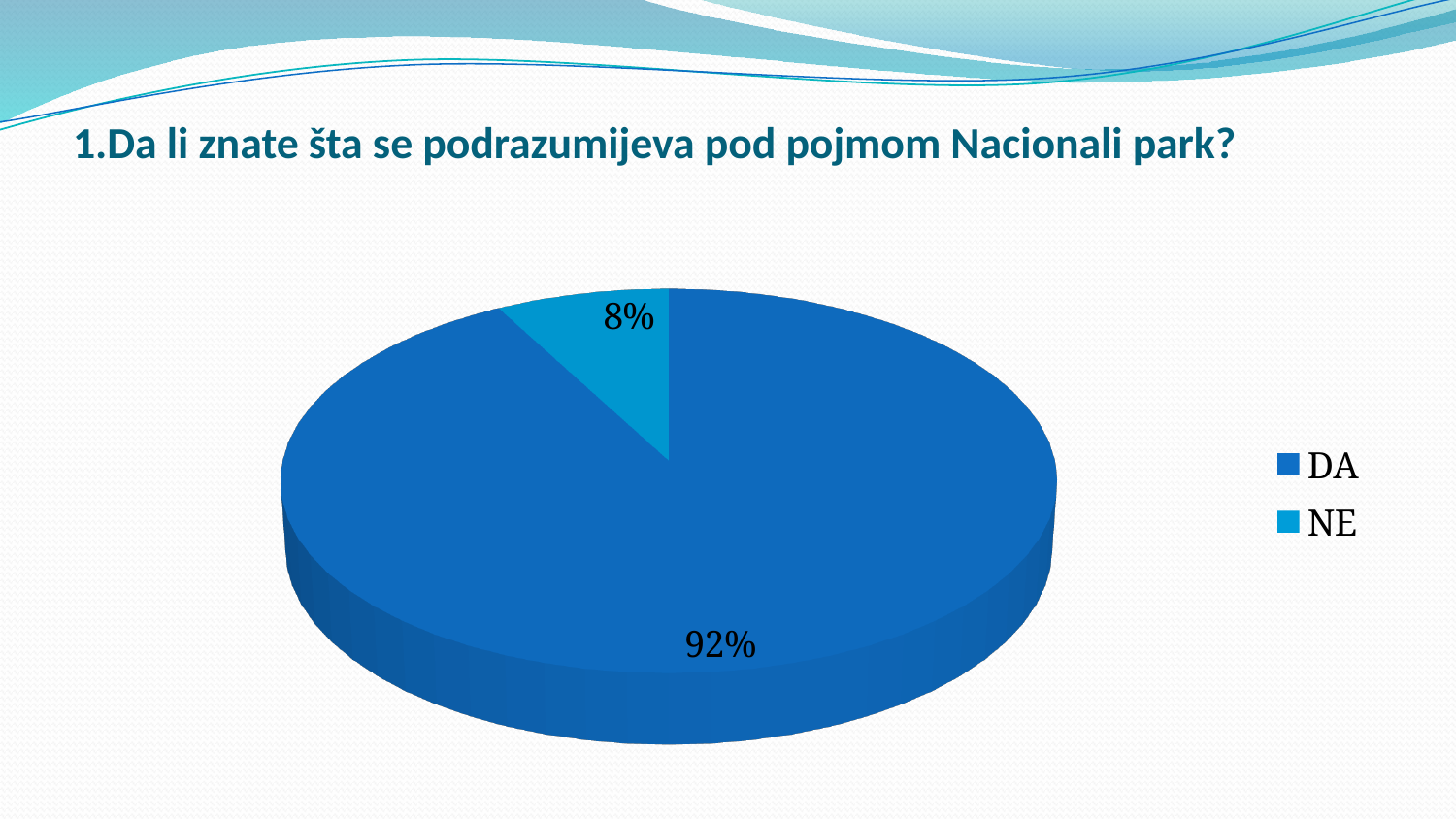
How many entries does the legend list? 2 What is the title of the slide above the chart? 1.Da li znate šta se podrazumijeva pod pojmom Nacionali park? What percentage of the pie is labelled NE? 8% Which slice is larger, DA or NE? DA Which legend entry is shown in the lighter blue colour? NE What share of the pie does the NE slice represent? 8% What is the difference in percentage points between the DA and NE slices? 84 How many slices does the pie chart have? 2 What kind of chart is shown on the slide? pie chart Which category has the largest share of the pie? DA What percentage of the pie is labelled DA? 92% Which category has the smallest share of the pie? NE